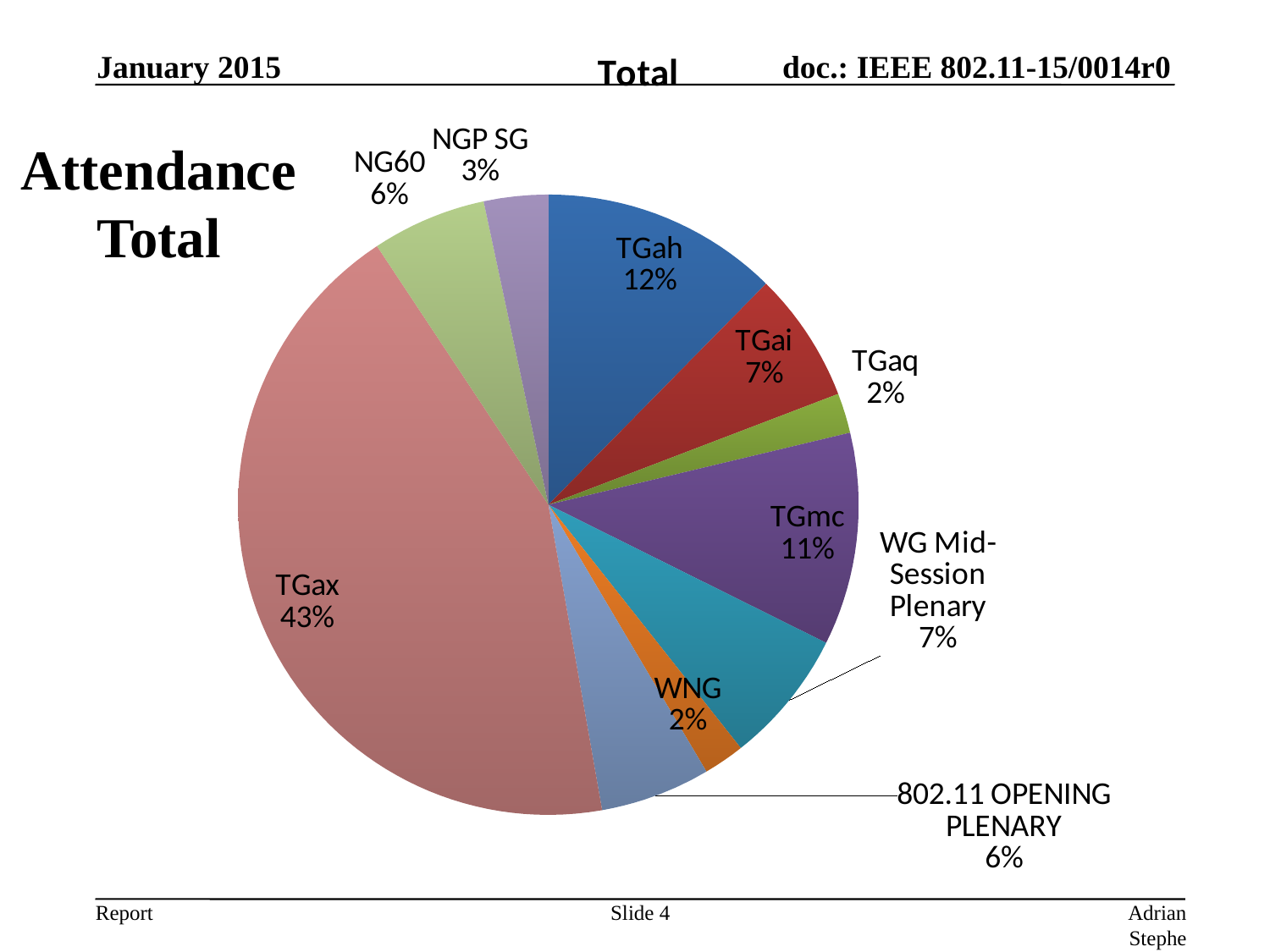
What is the value shown for TGmc? 11% Which slice is the largest? TGax What is the chart's title? Total What share of the pie does TGax have? 43% How many slices does the pie chart have? 10 What is the value shown for NGP SG? 3% What kind of chart is shown on the slide? pie chart What is the difference between the TGah and TGai values? 5% What is the value shown for WG Mid-Session Plenary? 7% What is the value shown for 802.11 OPENING PLENARY? 6% What is the value shown for TGah? 12% Which is larger, TGmc or NG60? TGmc